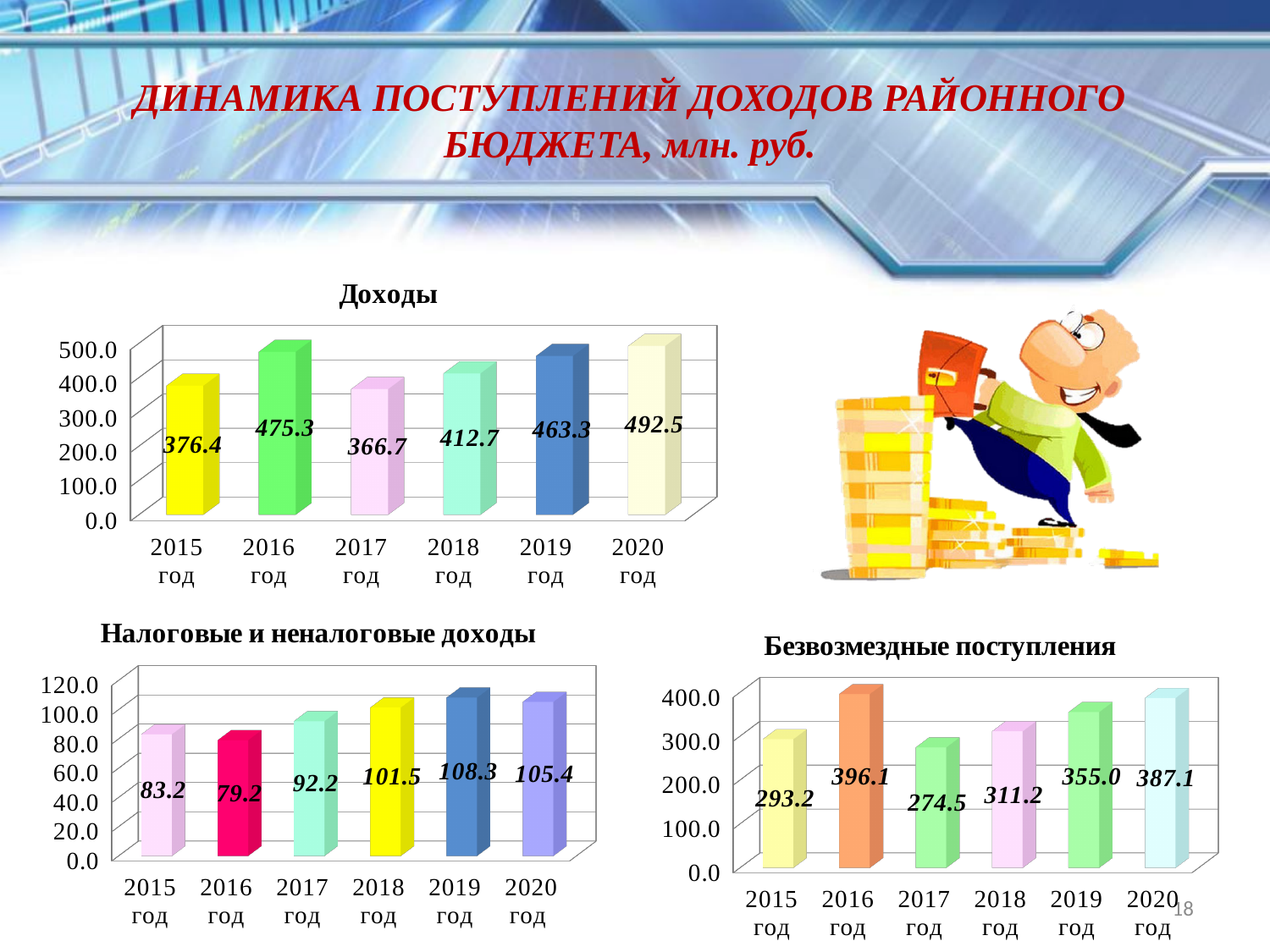
How many years are shown in the chart titled "Доходы"? 6 In the chart titled "Доходы", which year has the highest value? 2020 год In the chart titled "Безвозмездные поступления", what is the value for 2017 год? 274.5 In the chart titled "Налоговые и неналоговые доходы", what is the value for 2019 год? 108.3 In the chart titled "Налоговые и неналоговые доходы", which is larger: the value for 2018 год or 2017 год? 2018 год In the chart titled "Безвозмездные поступления", which year has the highest value? 2016 год In the chart titled "Доходы", what is the value for 2016 год? 475.3 In the chart titled "Налоговые и неналоговые доходы", which year has the lowest value? 2016 год What kind of chart is the chart titled "Безвозмездные поступления"? bar chart In the chart titled "Безвозмездные поступления", what is the difference between the values for 2016 год and 2015 год? 102.9 In the chart titled "Доходы", which year has the lowest value? 2017 год In the chart titled "Доходы", what is the difference between the values for 2020 год and 2015 год? 116.1